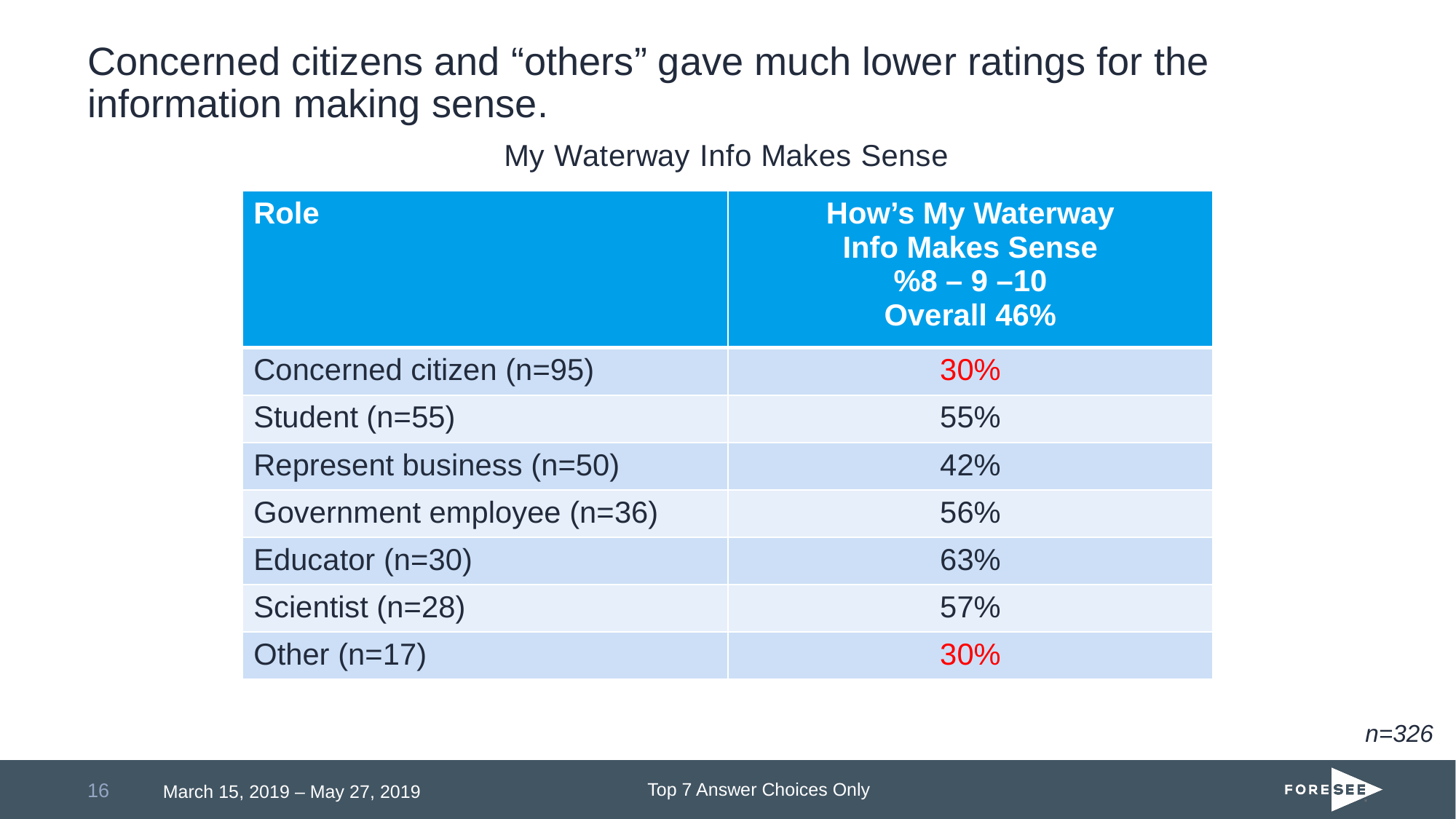
What overall percentage is shown in the column header of the My Waterway Info Makes Sense table? 46% What is the value for Concerned citizen (n=95) in the My Waterway Info Makes Sense table? 30% Which roles share the lowest value in the My Waterway Info Makes Sense table? Concerned citizen (n=95) and Other (n=17) What is the value for Represent business (n=50) in the My Waterway Info Makes Sense table? 42% Which values in the My Waterway Info Makes Sense table are shown in red? Concerned citizen (n=95) and Other (n=17), both 30% What is the difference between the values for Student (n=55) and Represent business (n=50) in the My Waterway Info Makes Sense table? 13% Which role has the highest value in the My Waterway Info Makes Sense table? Educator (n=30) What is the value for Educator (n=30) in the My Waterway Info Makes Sense table? 63% What is the value for Scientist (n=28) in the My Waterway Info Makes Sense table? 57% What is the difference between the values for Educator (n=30) and Concerned citizen (n=95) in the My Waterway Info Makes Sense table? 33% How many roles are listed in the My Waterway Info Makes Sense table? 7 Which is larger in the My Waterway Info Makes Sense table, the value for Government employee (n=36) or Represent business (n=50)? Government employee (n=36)